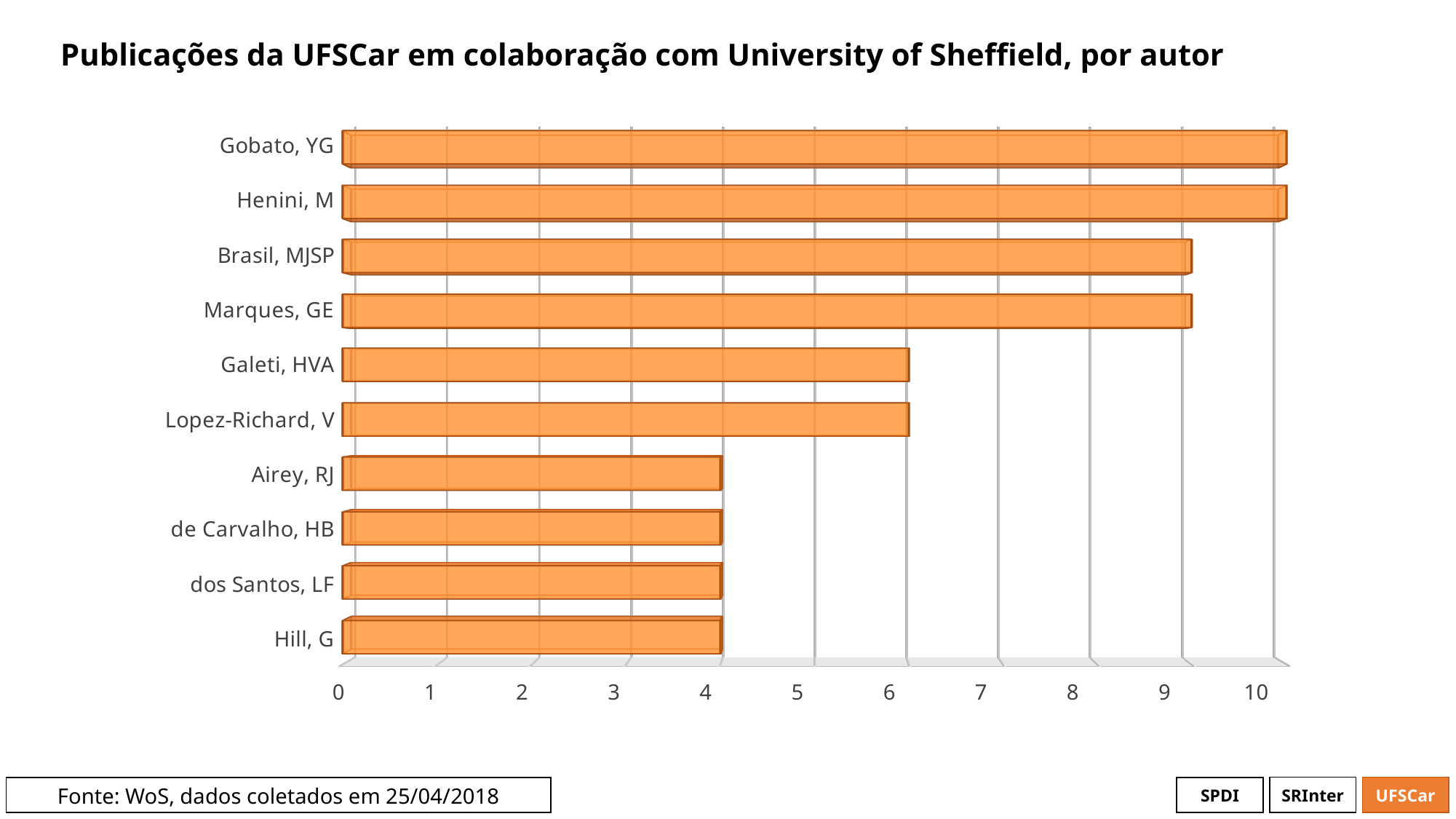
Is the value for Marques, GE greater or less than 8? greater What kind of chart is shown on the slide? bar chart What is the source stated at the bottom of the slide? WoS, dados coletados em 25/04/2018 How many publications does the bar for Hill, G reach on the axis? 4 How many authors are shown in the chart? 10 How many publications does the bar for Brasil, MJSP reach on the axis? 9 Which has more publications, Brasil, MJSP or Lopez-Richard, V? Brasil, MJSP How many publications does the bar for Gobato, YG reach on the axis? 10 How many publications does the bar for Galeti, HVA reach on the axis? 6 Is the value for Airey, RJ greater or less than 5? less What is the title of the chart? Publicações da UFSCar em colaboração com University of Sheffield, por autor Which has more publications, de Carvalho, HB or Henini, M? Henini, M